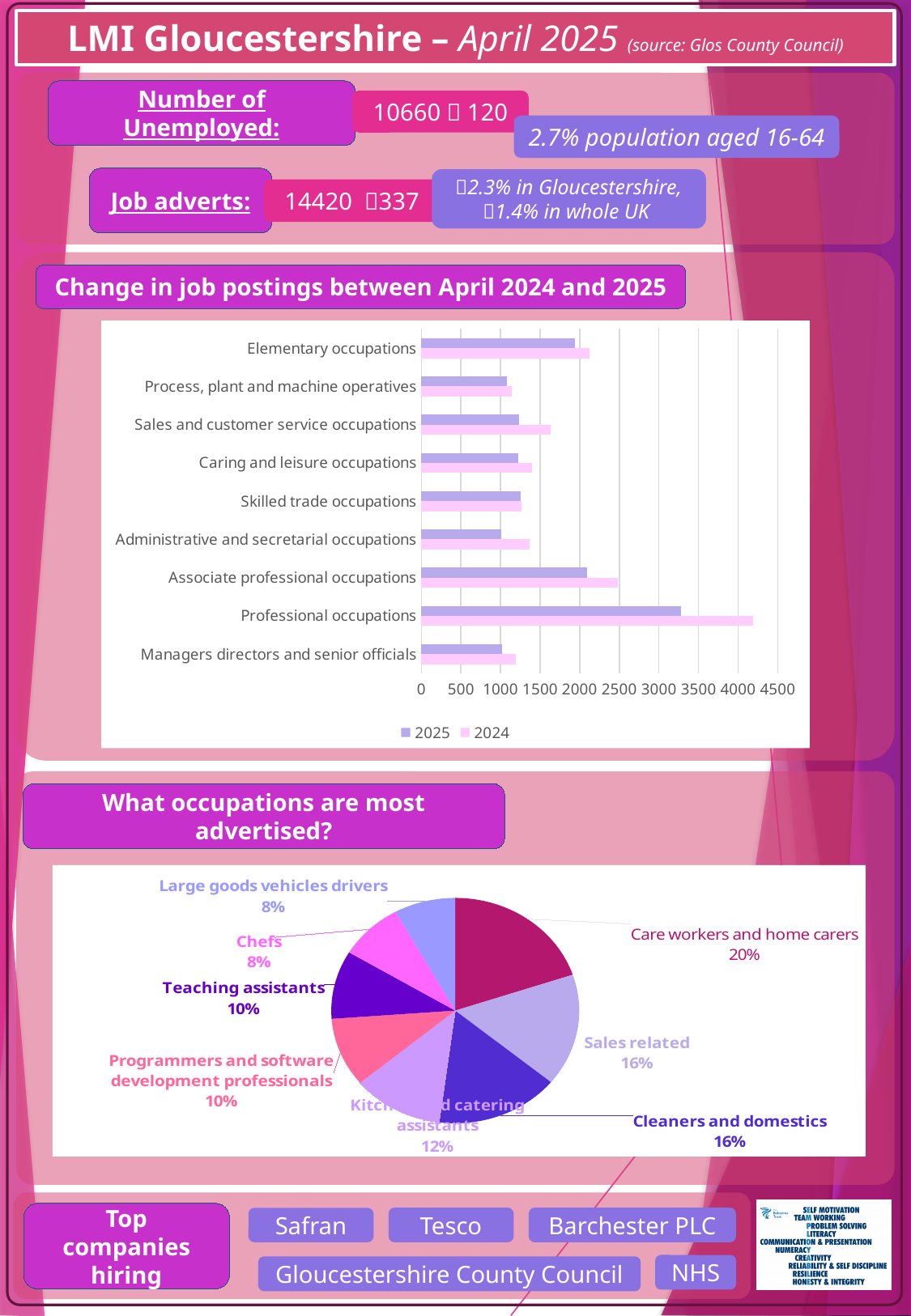
In the 'Change in job postings between April 2024 and 2025' chart, which series is shown in the lighter pink colour? 2024 In the 'Change in job postings between April 2024 and 2025' chart, for Associate professional occupations, which year has the larger value, 2024 or 2025? 2024 In the 'Change in job postings between April 2024 and 2025' chart, is the 2025 value for Administrative and secretarial occupations greater or less than 1500? less In the 'Change in job postings between April 2024 and 2025' chart, which occupation has the highest value for 2025? Professional occupations In the 'What occupations are most advertised?' pie chart, what is the difference between the share for Care workers and home carers and the share for Chefs? 12% In the 'Change in job postings between April 2024 and 2025' chart, what kind of chart is shown? Bar chart In the 'Change in job postings between April 2024 and 2025' chart, is the 2024 value for Professional occupations greater or less than 4000? greater In the 'Change in job postings between April 2024 and 2025' chart, how many occupation categories are plotted? 9 In the 'What occupations are most advertised?' pie chart, how many slices are there? 8 In the 'What occupations are most advertised?' pie chart, what is the value for Kitchen and catering assistants? 12% In the 'Change in job postings between April 2024 and 2025' chart, how many series does the legend list? 2 In the 'What occupations are most advertised?' pie chart, what share do Care workers and home carers have? 20%